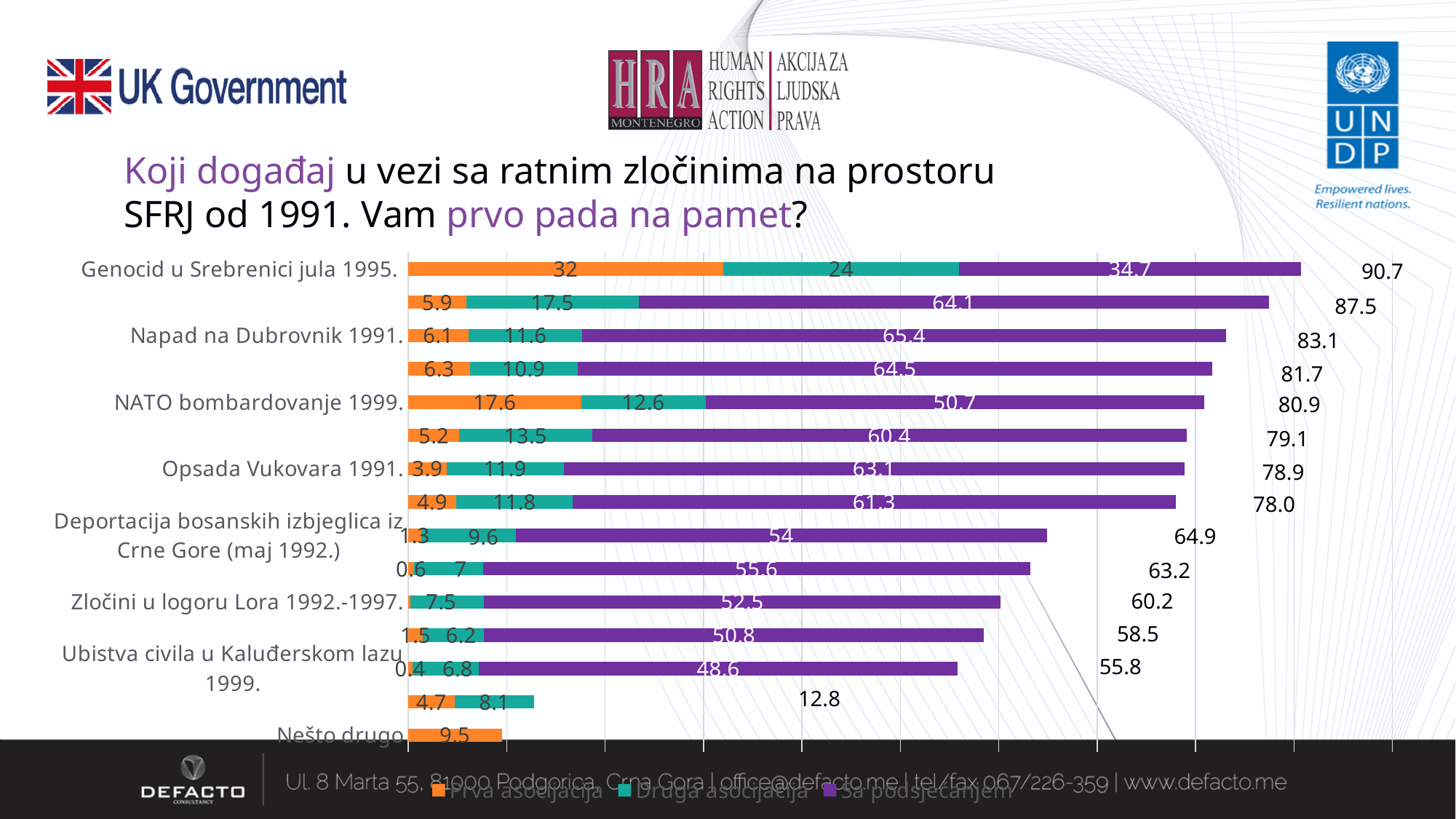
What is the 'Druga asocijacija' value for 'NATO bombardovanje 1999.'? 12.6 What is the difference between the totals for 'Genocid u Srebrenici jula 1995.' and 'Napad na Dubrovnik 1991.'? 7.6 How many series does the legend list? 3 What type of chart is shown on the slide? stacked bar chart Which is larger: the 'Prva asocijacija' value for 'NATO bombardovanje 1999.' or for 'Napad na Dubrovnik 1991.'? NATO bombardovanje 1999. Which category has the highest total? Genocid u Srebrenici jula 1995. What is the 'Prva asocijacija' value for 'Nešto drugo'? 9.5 What is the 'Prva asocijacija' value for 'Genocid u Srebrenici jula 1995.'? 32 What is the total shown for the 'Opsada Vukovara 1991.' bar? 78.9 Which colour represents the 'Sa podsjećanjem' series? purple What is the 'Sa podsjećanjem' value for 'Napad na Dubrovnik 1991.'? 65.4 What is the total shown for the 'Ubistva civila u Kaluđerskom lazu 1999.' bar? 55.8